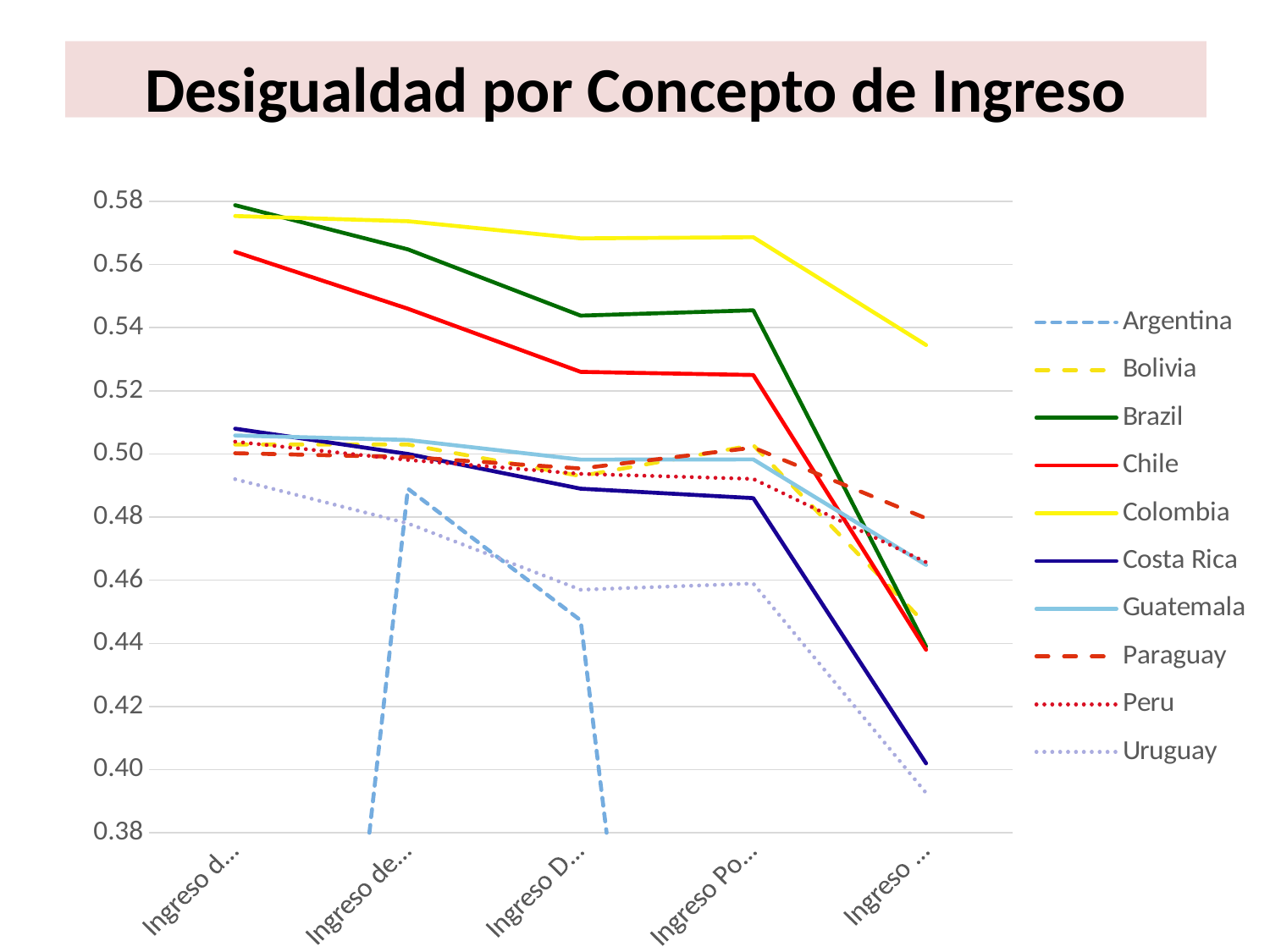
Is the value for Colombia at the last x-axis point greater or less than 0.52? greater Is the value for Uruguay at the first x-axis point greater or less than 0.50? less How many series does the legend list? 10 At the last x-axis point, which is larger, the value for Colombia or the value for Brazil? Colombia What kind of chart is shown on the slide? line chart Is the value for Costa Rica at the last x-axis point greater or less than 0.42? less How many points are there along the x axis? 5 Which series has the lowest value at the last point on the x axis? Uruguay Does the Colombia line rise or fall from the first to the last point on the x axis? fall What is the title of the chart? Desigualdad por Concepto de Ingreso Which series has the highest value at the last point on the x axis? Colombia